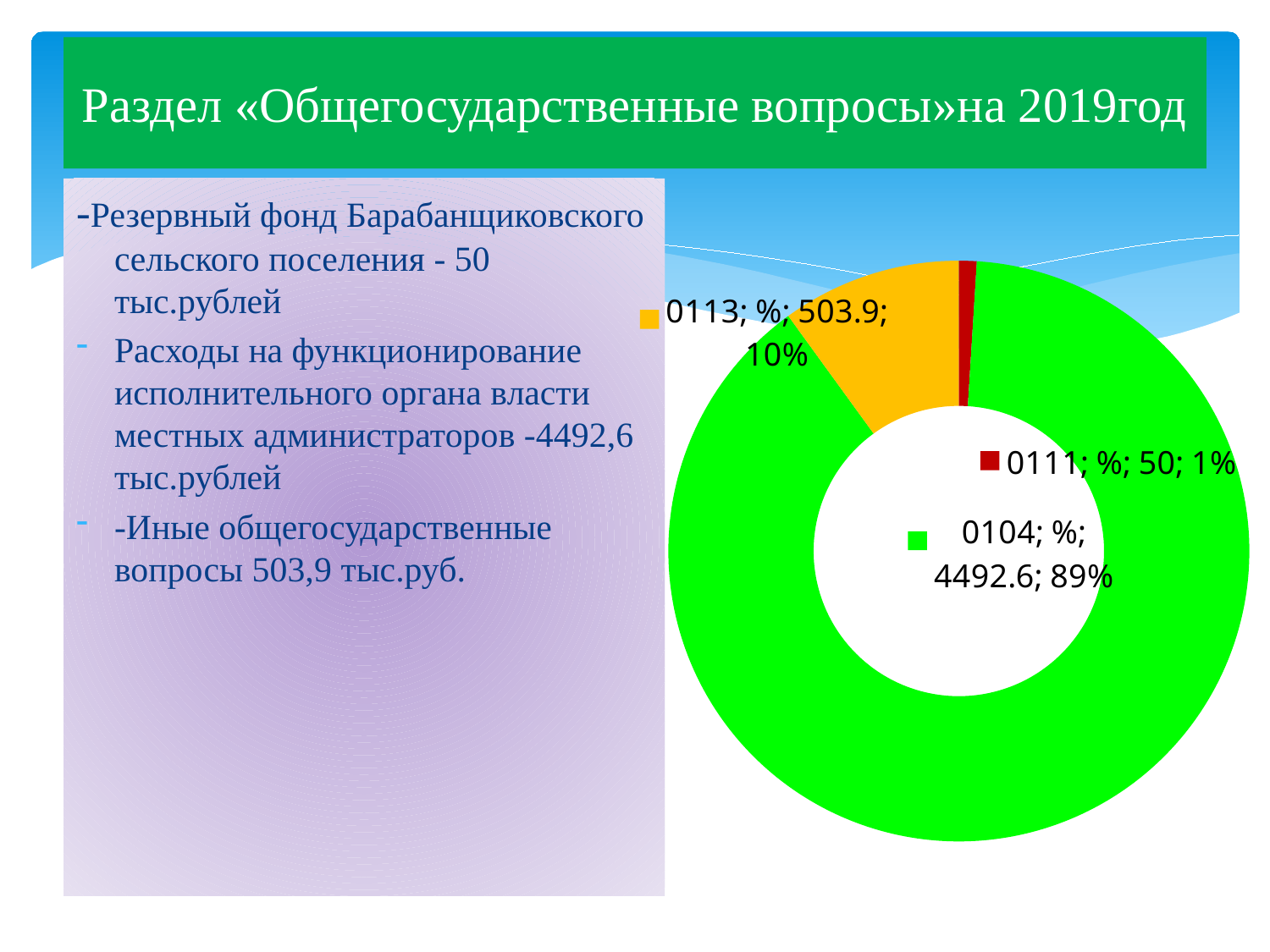
Which category has the largest slice? 0104 What share of the doughnut does category 0104 represent? 89% What kind of chart is shown on the slide? doughnut chart What is the value shown for category 0113? 503.9 What share of the doughnut does category 0111 represent? 1% What colour is the slice for category 0104? green Which category has the smallest slice? 0111 How many slices does the doughnut chart have? 3 What share of the doughnut does category 0113 represent? 10% Which is larger, the value for 0113 or the value for 0111? 0113 What is the value shown for category 0104? 4492.6 What is the value shown for category 0111? 50